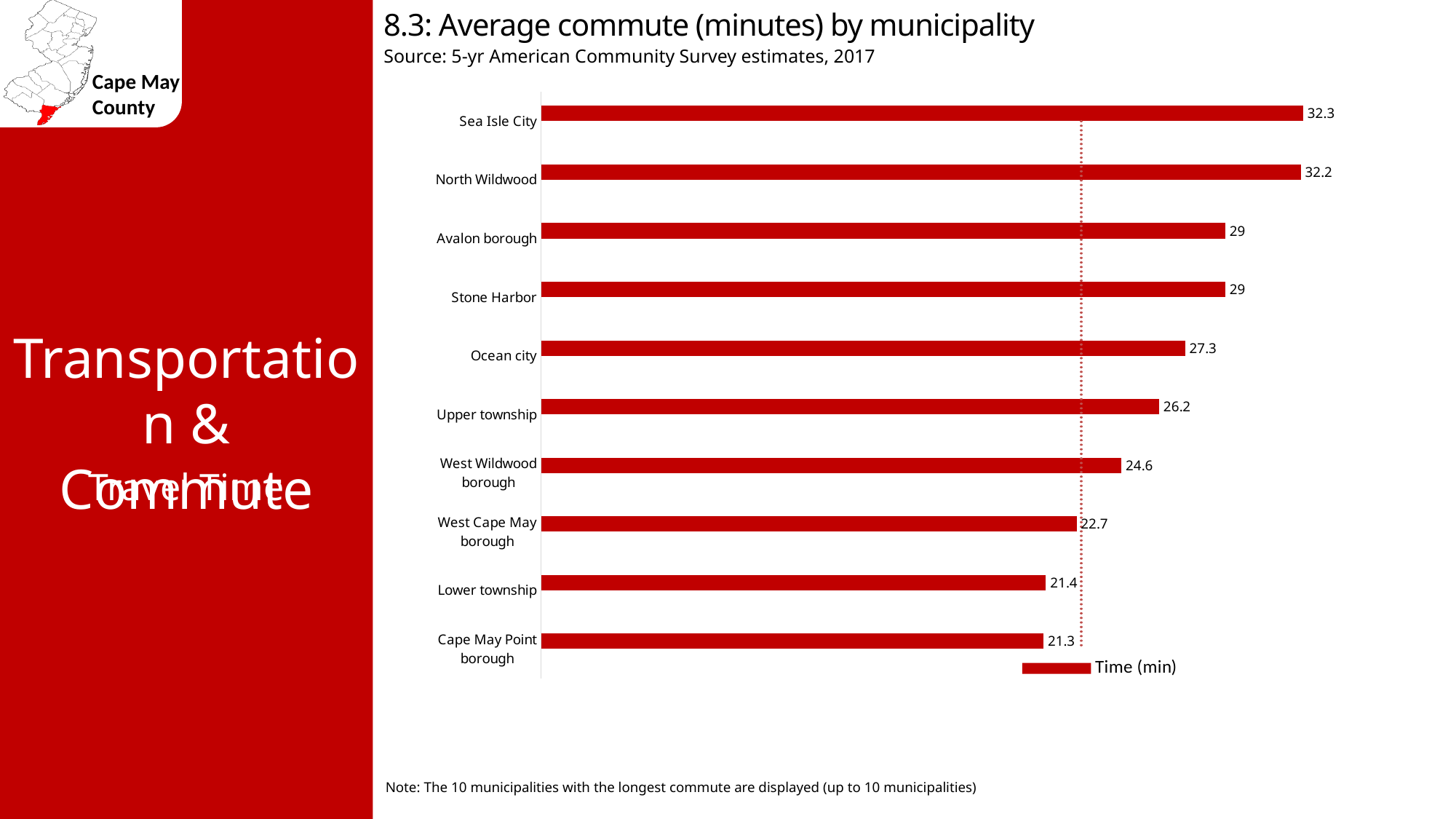
Which has a longer average commute, Avalon borough or Ocean city? Avalon borough How many municipalities are shown on the chart? 10 Which municipality has the longest average commute? Sea Isle City What is the difference in average commute time between Ocean city and Upper township? 1.1 What is the legend entry for the series shown on the chart? Time (min) What is the difference in average commute time between Sea Isle City and Cape May Point borough? 11 What is the average commute time for West Wildwood borough? 24.6 What kind of chart is used to show average commute by municipality? Bar chart What is the average commute time for Lower township? 21.4 What is the average commute time for Sea Isle City? 32.3 Which municipality has the shortest average commute shown on the chart? Cape May Point borough What is the average commute time for Upper township? 26.2